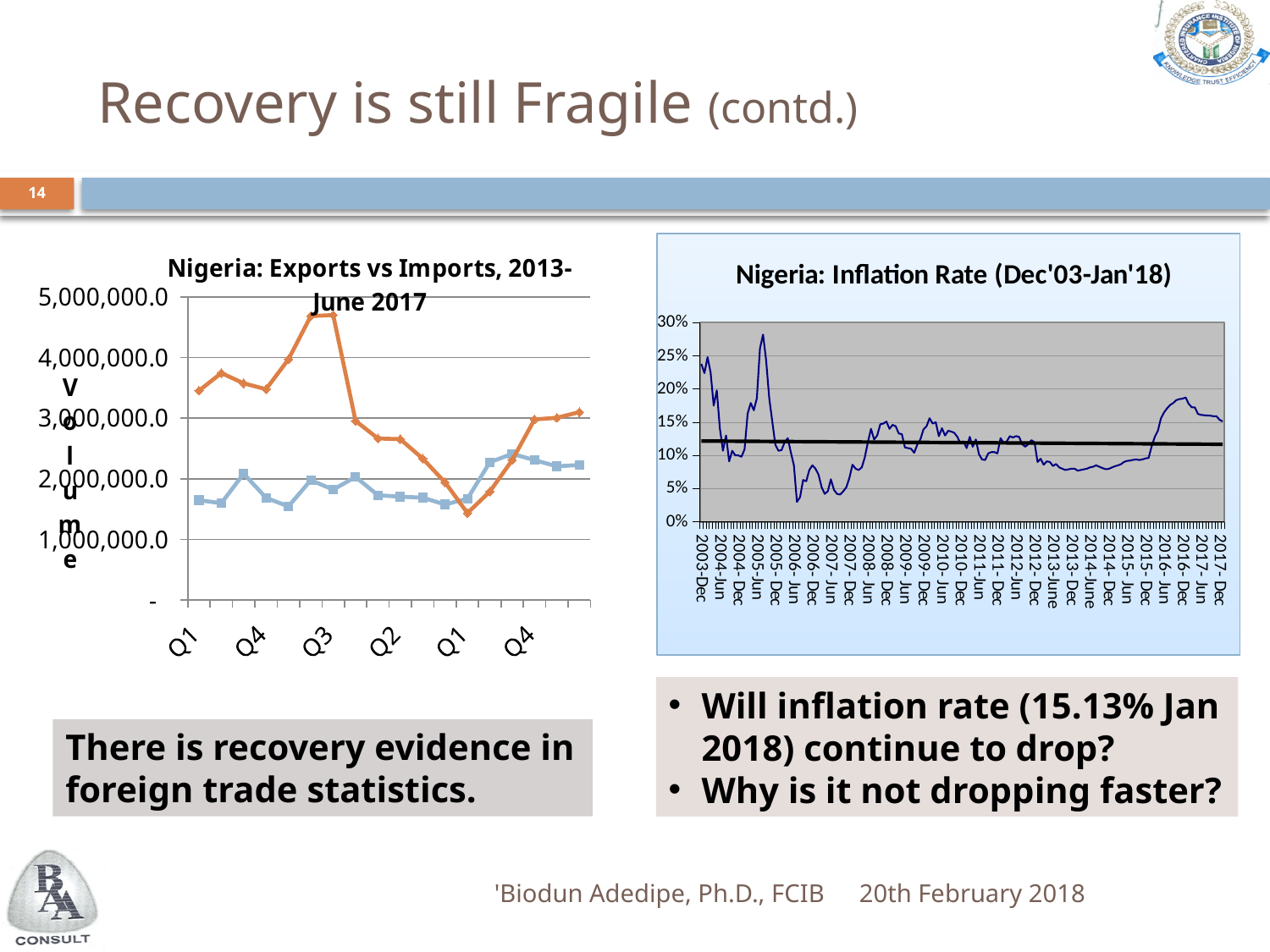
In the 'Nigeria: Exports vs Imports, 2013-June 2017' chart, is the highest point of the blue line greater or less than 3,000,000.0? less What kind of chart is the 'Nigeria: Exports vs Imports, 2013-June 2017' chart? line chart In the 'Nigeria: Exports vs Imports, 2013-June 2017' chart, is the highest point of the orange line greater or less than 4,000,000.0? greater What is the title of the chart on the right side of the slide? Nigeria: Inflation Rate (Dec'03-Jan'18) In the 'Nigeria: Inflation Rate (Dec'03-Jan'18)' chart, is the highest inflation rate plotted greater or less than 25%? greater What kind of chart is the 'Nigeria: Inflation Rate (Dec'03-Jan'18)' chart? line chart In the 'Nigeria: Exports vs Imports, 2013-June 2017' chart, at the first quarter plotted, which line is higher, the orange line or the blue line? the orange line What is the highest value shown on the y axis of the 'Nigeria: Inflation Rate (Dec'03-Jan'18)' chart? 30%